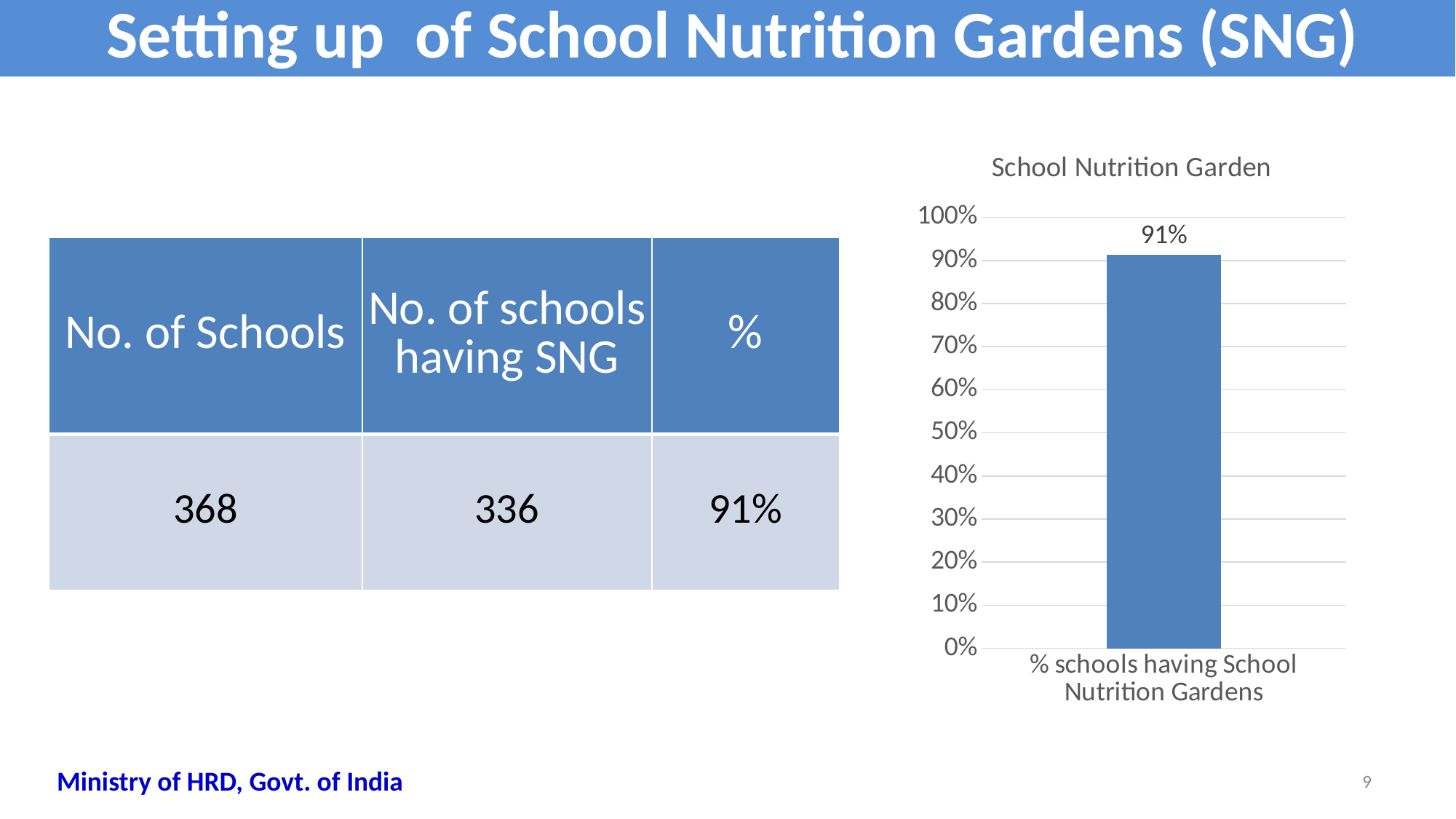
Is the value for '% schools having School Nutrition Gardens' greater or less than 90%? greater What is the value shown for '% schools having School Nutrition Gardens' in the chart? 91% What is the highest value shown on the chart's vertical axis? 100% What is the category label on the x axis of the chart? % schools having School Nutrition Gardens What kind of chart is shown on the slide? bar chart Is the value for '% schools having School Nutrition Gardens' greater or less than 100%? less How many bars does the chart have? 1 What is the title of the chart? School Nutrition Garden